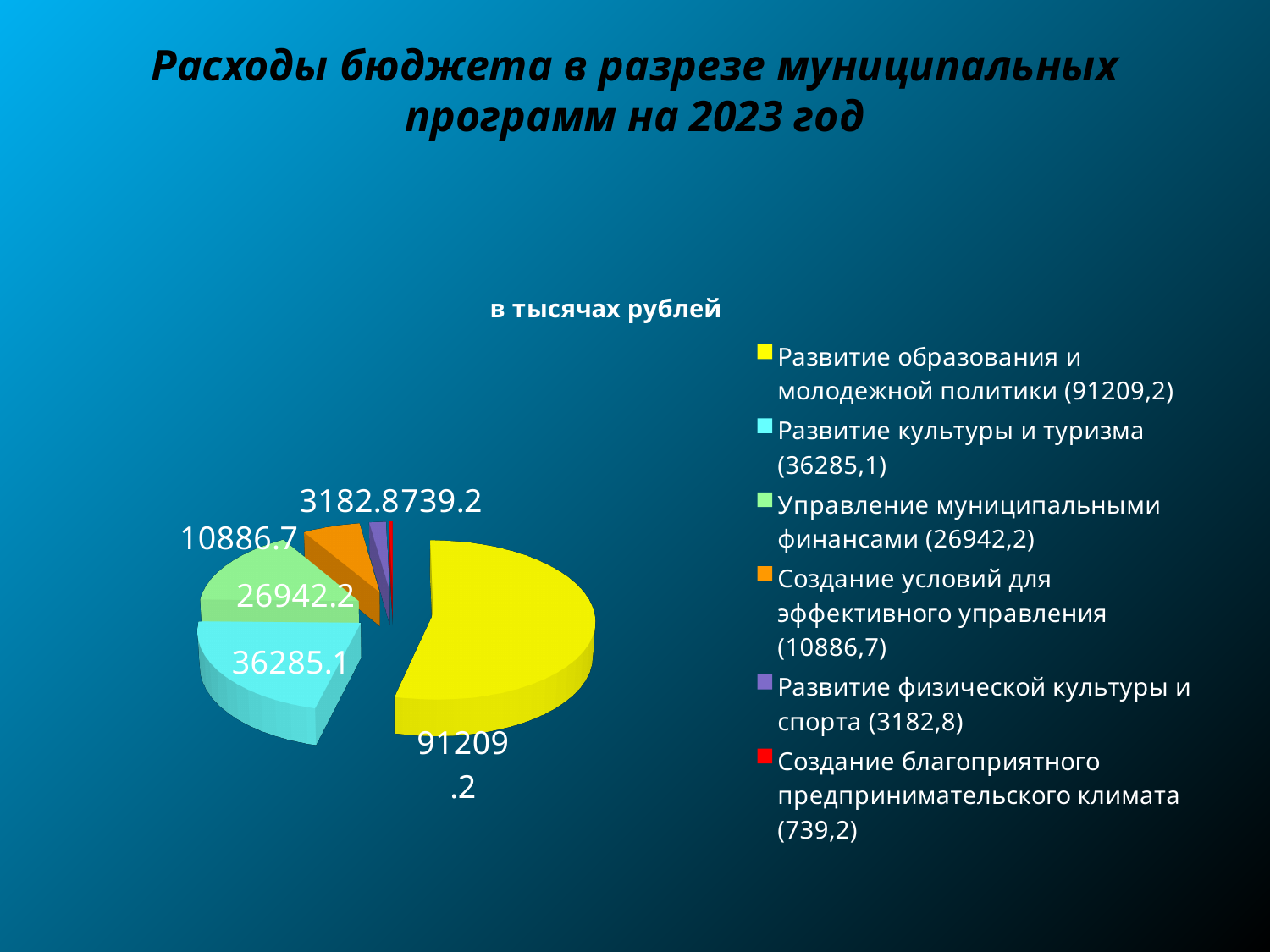
Which category has the smallest slice of the pie? Создание благоприятного предпринимательского климата What is the difference between the values for Развитие физической культуры и спорта and Создание благоприятного предпринимательского климата? 2443.6 What is the value for Развитие образования и молодежной политики? 91209.2 What is the value for Развитие культуры и туризма? 36285.1 Which is larger: Управление муниципальными финансами or Создание условий для эффективного управления? Управление муниципальными финансами What is the value for Создание благоприятного предпринимательского климата? 739.2 How many categories does the legend list? 6 What is the value for Управление муниципальными финансами? 26942.2 What is the difference between the values for Развитие образования и молодежной политики and Развитие культуры и туризма? 54924.1 What type of chart is shown on the slide? Pie chart Which category has the largest slice of the pie? Развитие образования и молодежной политики What is the value for Создание условий для эффективного управления? 10886.7